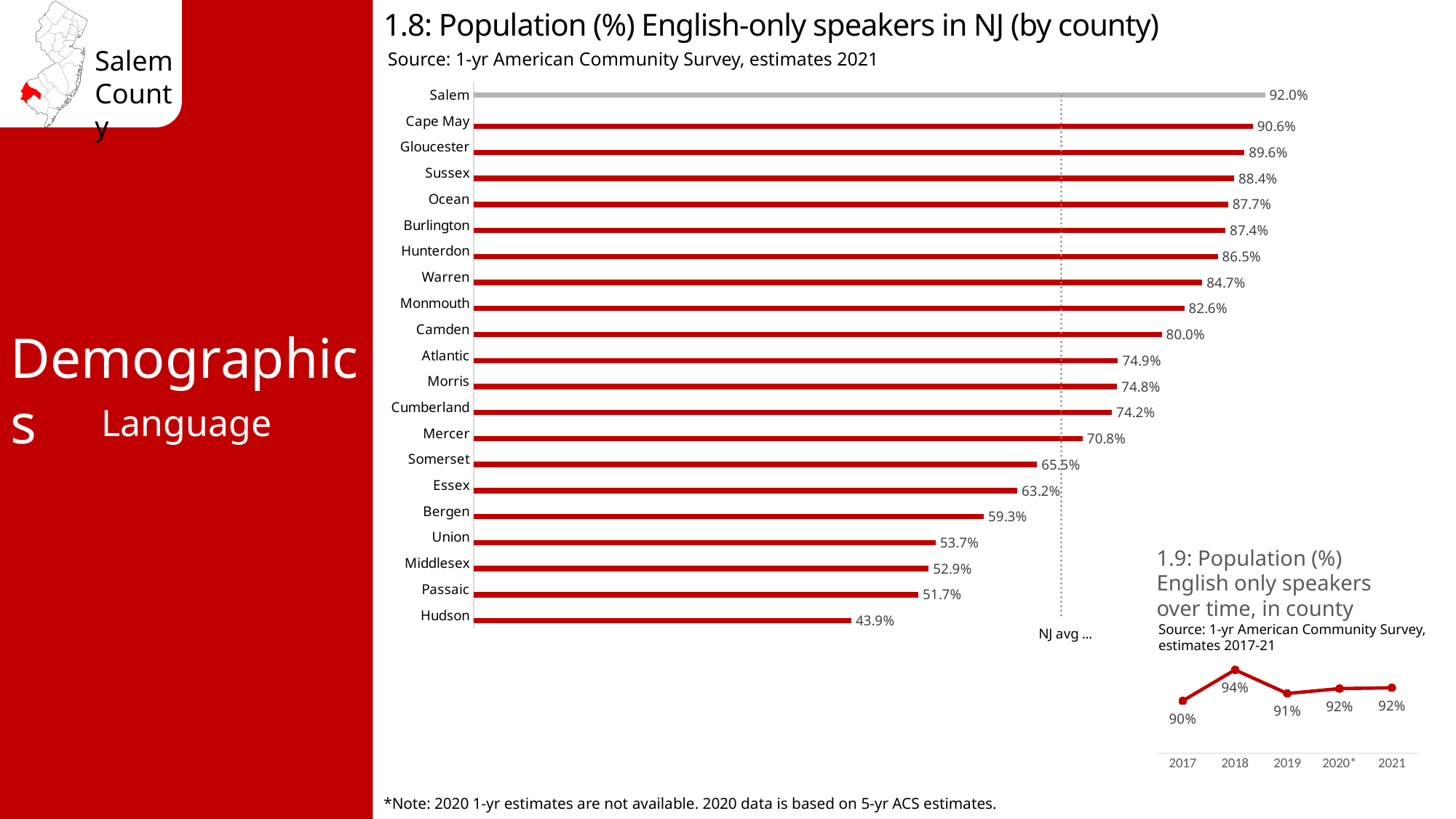
In chart 1.8, what is the difference between the values for Salem and Hudson? 48.1% In chart 1.8, which county has a larger value, Bergen or Union? Bergen What kind of chart is chart 1.8? Bar chart In chart 1.9, which year has the lowest value? 2017 In chart 1.9 (Population (%) English only speakers over time, in county), what is the value for 2018? 94% In chart 1.8, which county has the lowest percentage of English-only speakers? Hudson In chart 1.8, what is the value for Hudson? 43.9% In chart 1.8, which county has the highest percentage of English-only speakers? Salem In chart 1.8 (Population (%) English-only speakers in NJ by county), what is the value for Salem? 92.0% How many counties are shown in chart 1.8? 21 In chart 1.8, what is the value for Mercer? 70.8% What kind of chart is chart 1.9? Line chart